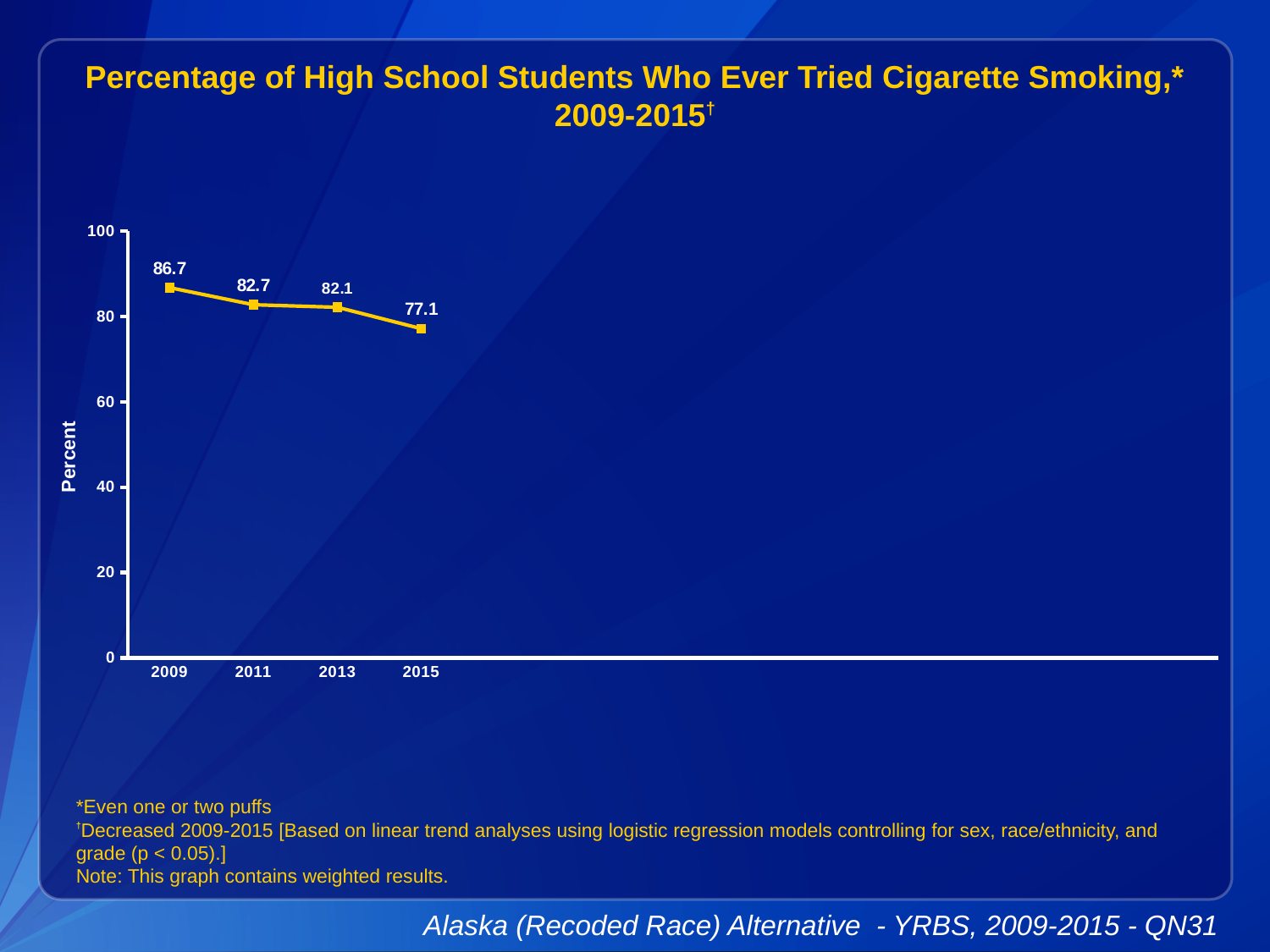
What kind of chart is shown on the slide? line chart How many years are plotted on the chart? 4 What is the difference between the 2009 value and the 2015 value? 9.6 Which year has the lowest percentage? 2015 Is the value for 2015 greater or less than 80? less Which year has the highest percentage? 2009 What is the value plotted for 2011? 82.7 Which is larger, the value for 2009 or the value for 2013? 2009 Do the values rise or fall from 2009 to 2015? fall What percentage of high school students had ever tried cigarette smoking in 2009? 86.7 What is the difference between the 2011 value and the 2013 value? 0.6 What is the value plotted for 2015? 77.1